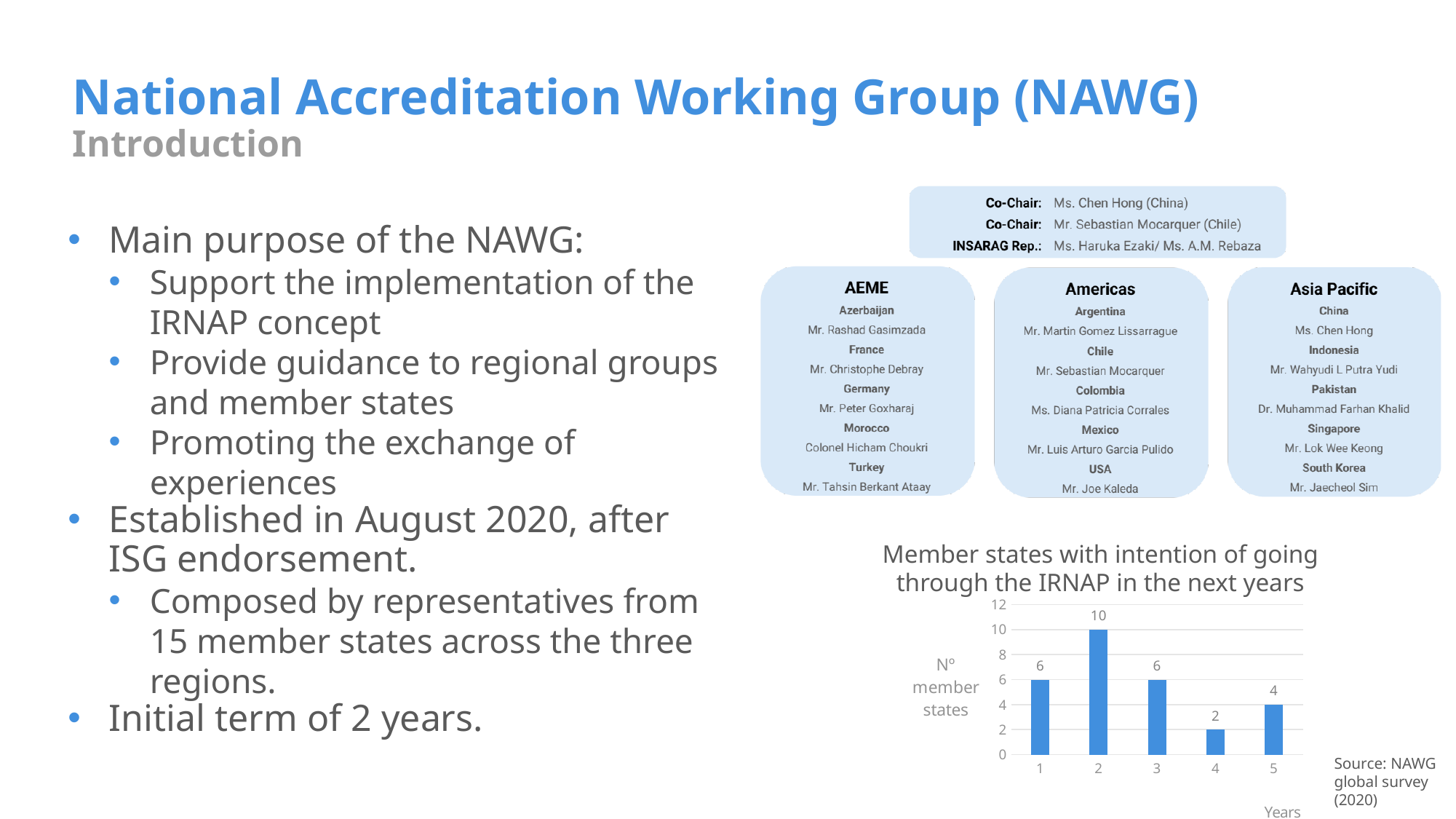
What is the title of the chart? Member states with intention of going through the IRNAP in the next years Which year has the highest number of member states? 2 What is the number of member states for year 2? 10 Which year has the lowest number of member states? 4 Which is larger, the value for year 3 or the value for year 5? Year 3 What kind of chart is shown on the slide? Bar chart How many years are shown on the x axis of the chart? 5 What is the number of member states for year 4? 2 What is the difference between the values for year 2 and year 4? 8 What is the number of member states for year 1? 6 Is the value for year 2 greater or less than 8? greater What is the number of member states for year 5? 4